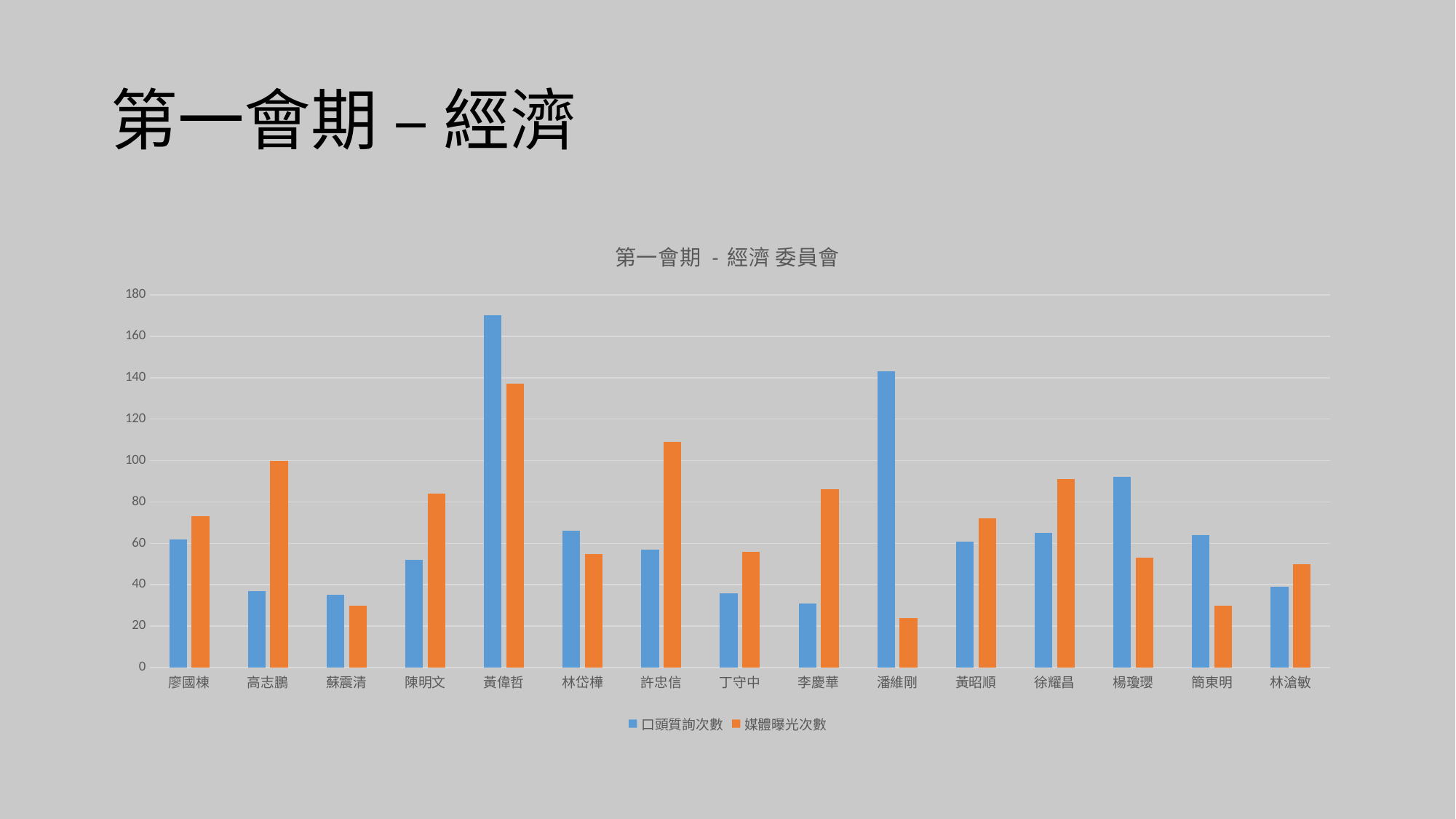
What is the title of the chart? 第一會期 - 經濟 委員會 Is the 口頭質詢次數 value for 黃偉哲 greater or less than 160? greater How many legislators (categories) are shown on the x axis? 15 What kind of chart is shown on the slide? bar chart Is the 口頭質詢次數 value for 潘維剛 greater or less than 120? greater Is the 媒體曝光次數 value for 許忠信 greater or less than 100? greater Which legislator has the highest 媒體曝光次數? 黃偉哲 For 高志鵬, which is larger: 口頭質詢次數 or 媒體曝光次數? 媒體曝光次數 How many series does the legend list? 2 Which legislator has the lowest 媒體曝光次數? 潘維剛 Which legislator has the highest 口頭質詢次數? 黃偉哲